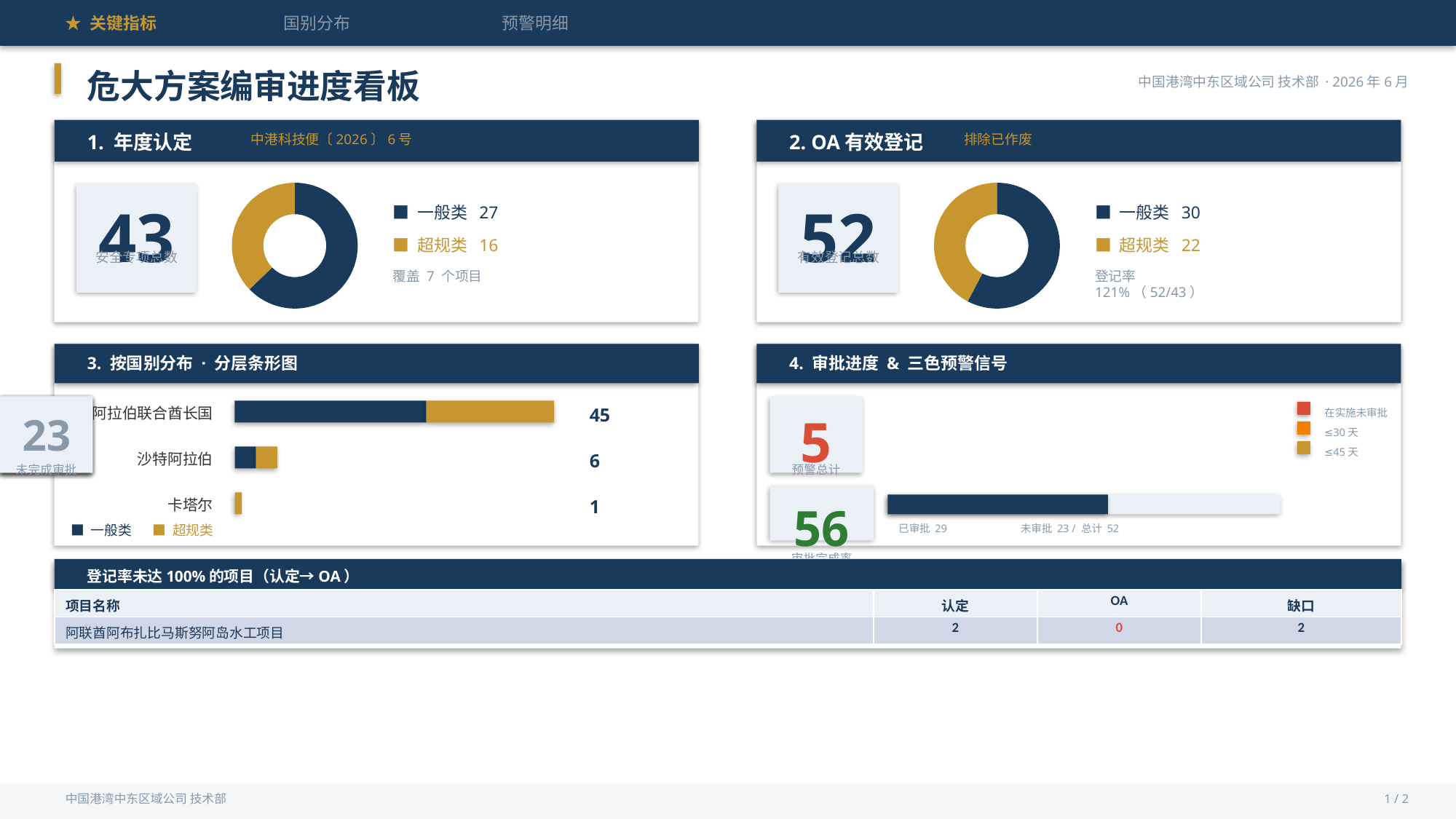
In the "3. 按国别分布 · 分层条形图" chart, which country has the lowest value? 卡塔尔 In the "3. 按国别分布 · 分层条形图" chart, what is the difference between 阿拉伯联合酋长国 and 沙特阿拉伯? 39 In the "1. 年度认定" donut chart, what is the value for 超规类? 16 In the "3. 按国别分布 · 分层条形图" chart, what is the total value for 阿拉伯联合酋长国? 45 In the "3. 按国别分布 · 分层条形图" chart, how many countries are shown? 3 In the "4. 审批进度 & 三色预警信号" progress bar, what is the value for 已审批? 29 In the "1. 年度认定" donut chart, what is the difference between 一般类 and 超规类? 11 In the "1. 年度认定" donut chart, what is the value for 一般类? 27 In the "2. OA 有效登记" donut chart, what is the value for 超规类? 22 In the "2. OA 有效登记" donut chart, which category is larger, 一般类 or 超规类? 一般类 What kind of chart is shown in the "3. 按国别分布 · 分层条形图" panel? Stacked bar chart In the "3. 按国别分布 · 分层条形图" chart, how many series does the legend list? 2